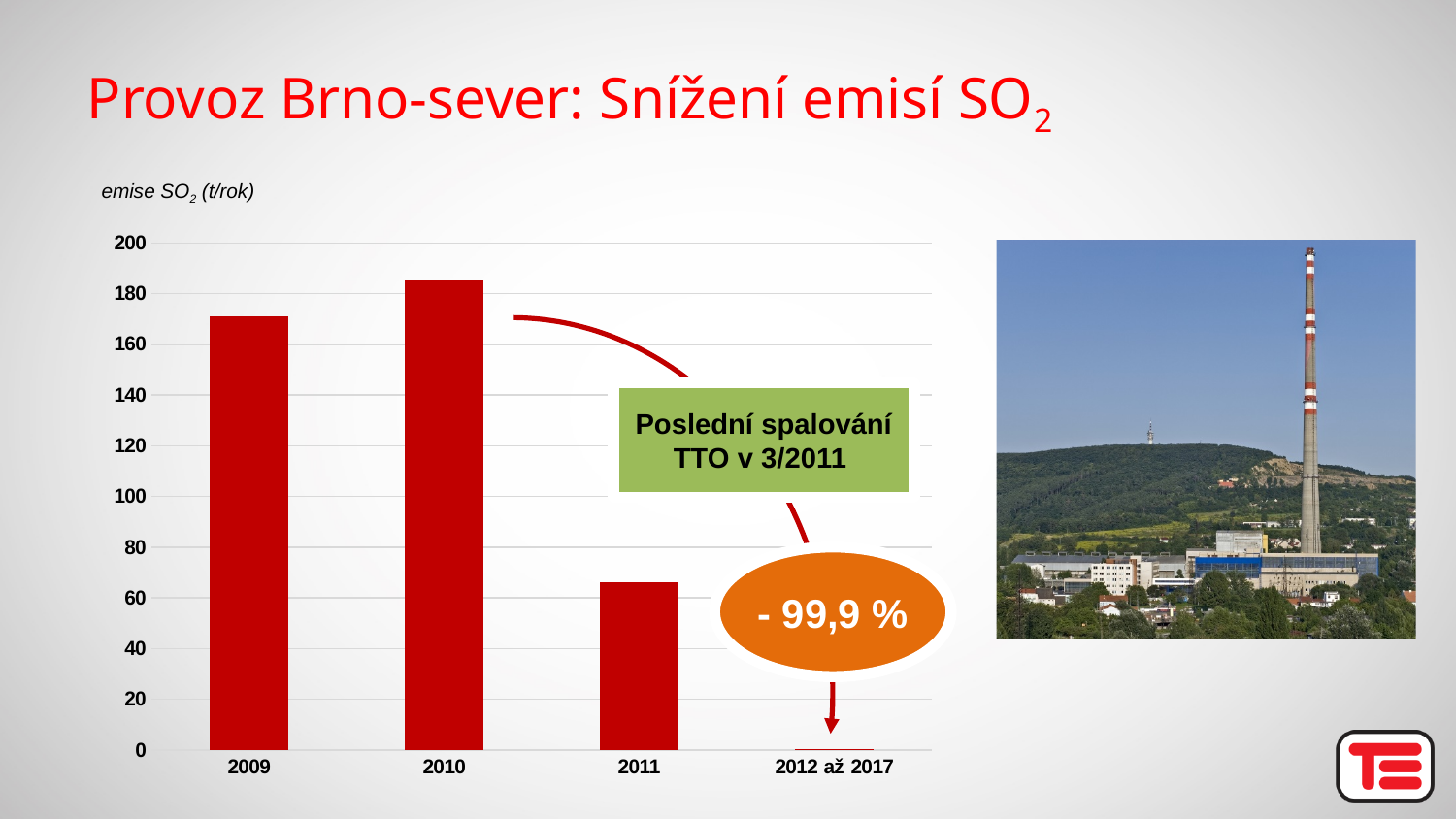
From 2010 to 2012 až 2017, do the SO2 emissions rise or fall? fall Is the value for 2010 greater or less than 180? greater Which year has the highest SO2 emissions in the chart? 2010 Which category has the lowest SO2 emissions in the chart? 2012 až 2017 Is the value for 2009 greater or less than 160? greater What kind of chart is shown on the slide? bar chart How many categories are shown on the x axis of the chart? 4 What unit label is shown above the y axis of the chart? emise SO2 (t/rok) Which has higher SO2 emissions, 2009 or 2010? 2010 What percentage change is shown in the orange oval on the chart? - 99,9 % Which has higher SO2 emissions, 2009 or 2011? 2009 Is the value for 2011 greater or less than 100? less